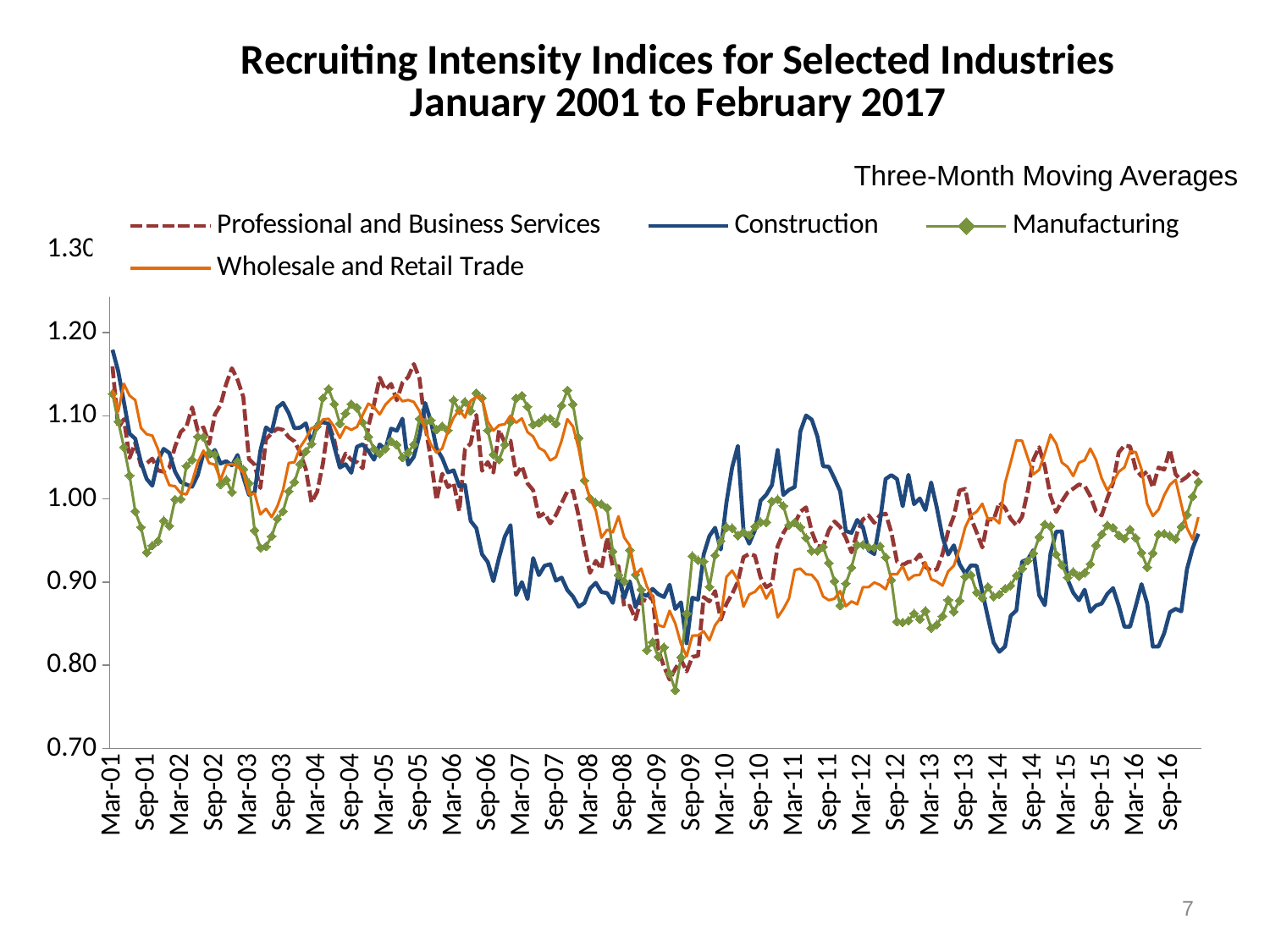
Is the value for Manufacturing at Sep-12 greater or less than 0.90? less Is the value for Manufacturing at Sep-09 greater or less than 0.80? greater Which series is drawn with a dashed line? Professional and Business Services Does the Construction series rise or fall overall from Mar-01 to Sep-09? fall How many series does the legend list? 4 Is the value for Wholesale and Retail Trade at Sep-14 greater or less than 1.00? greater What is the title of the chart? Recruiting Intensity Indices for Selected Industries January 2001 to February 2017 At Sep-16, which is higher: Construction or Professional and Business Services? Professional and Business Services What kind of chart is shown on the slide? line chart At Mar-14, which is higher: Construction or Wholesale and Retail Trade? Wholesale and Retail Trade